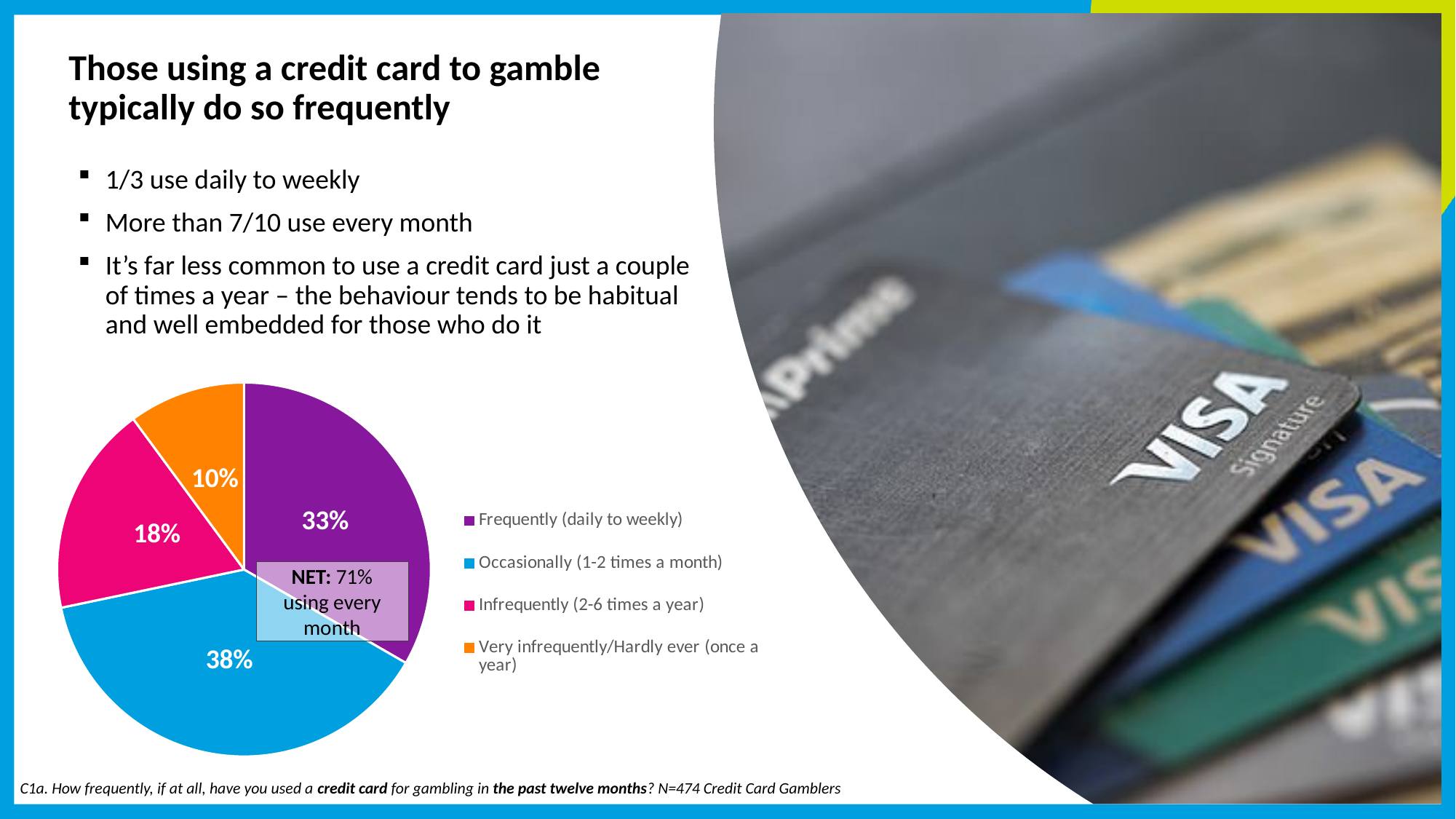
How many categories does the pie chart show? 4 What is the NET percentage using a credit card every month, as labelled on the chart? 71% What is the difference in percentage points between the Occasionally and Frequently slices? 5 What percentage of credit card gamblers use a credit card frequently (daily to weekly)? 33% Which category has the smallest share of the pie? Very infrequently/Hardly ever (once a year) What kind of chart is shown on the slide? Pie chart What percentage use a credit card very infrequently/hardly ever (once a year)? 10% Which category has the largest share of the pie? Occasionally (1-2 times a month) What colour is the slice for Infrequently (2-6 times a year)? Pink What percentage use a credit card infrequently (2-6 times a year)? 18% What percentage use a credit card occasionally (1-2 times a month)? 38% Which is larger: the Infrequently slice or the Very infrequently/Hardly ever slice? Infrequently (2-6 times a year)